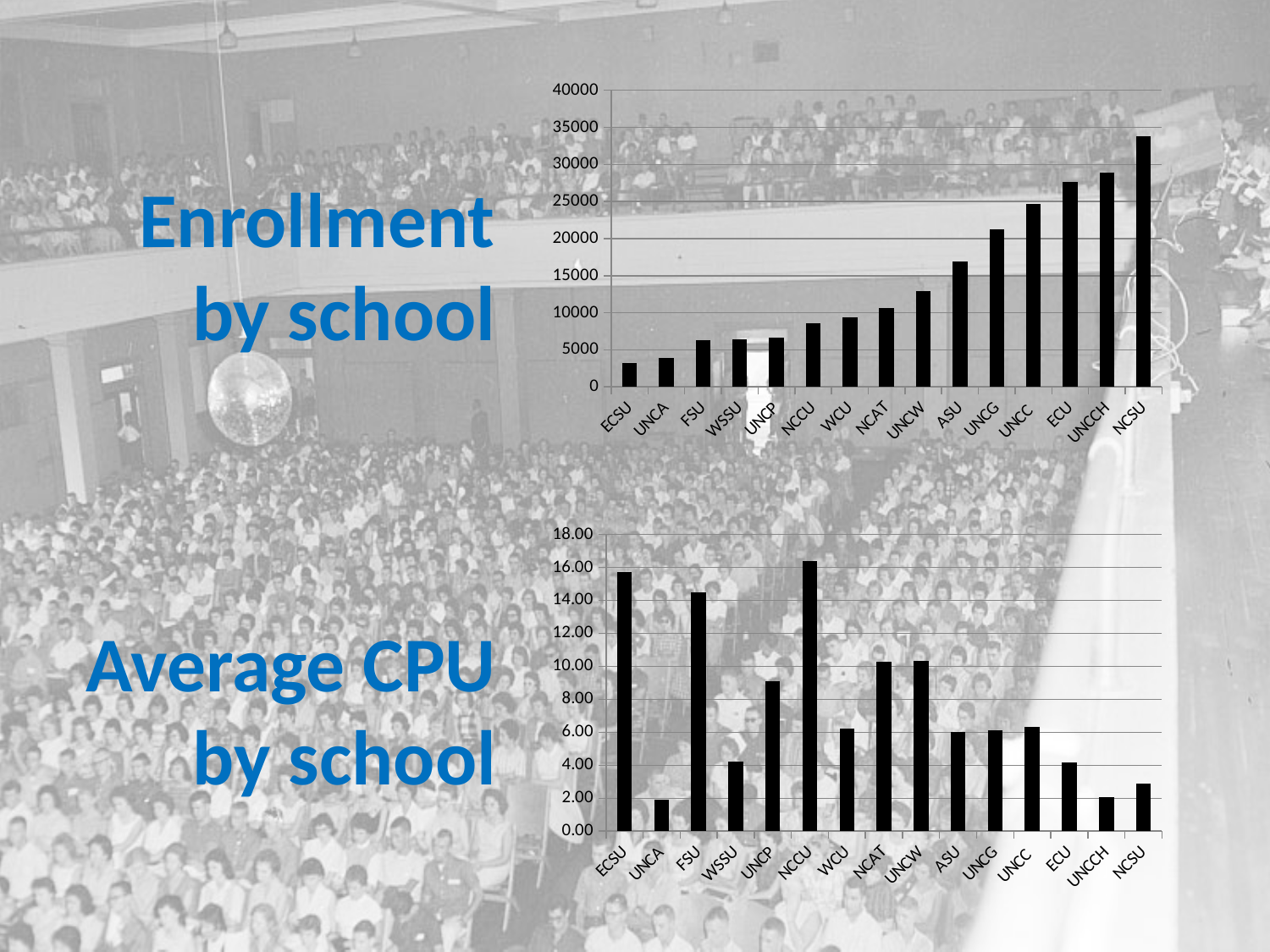
On the Enrollment by school chart, is the value for ASU greater or less than 15000? greater On the Average CPU by school chart, which has the larger value, ECSU or UNCA? ECSU What kind of chart is the Enrollment by school chart? bar chart On the Average CPU by school chart, is the value for UNCCH greater or less than 4.00? less On the Average CPU by school chart, is the value for ECSU greater or less than 14.00? greater On the Enrollment by school chart, do the values rise or fall from left to right along the x axis? rise On the Average CPU by school chart, which school has the highest average CPU? NCCU How many schools are shown on the Enrollment by school chart? 15 On the Enrollment by school chart, which has the larger enrollment, UNCG or WCU? UNCG On the Enrollment by school chart, which school has the highest enrollment? NCSU On the Enrollment by school chart, which school has the lowest enrollment? ECSU